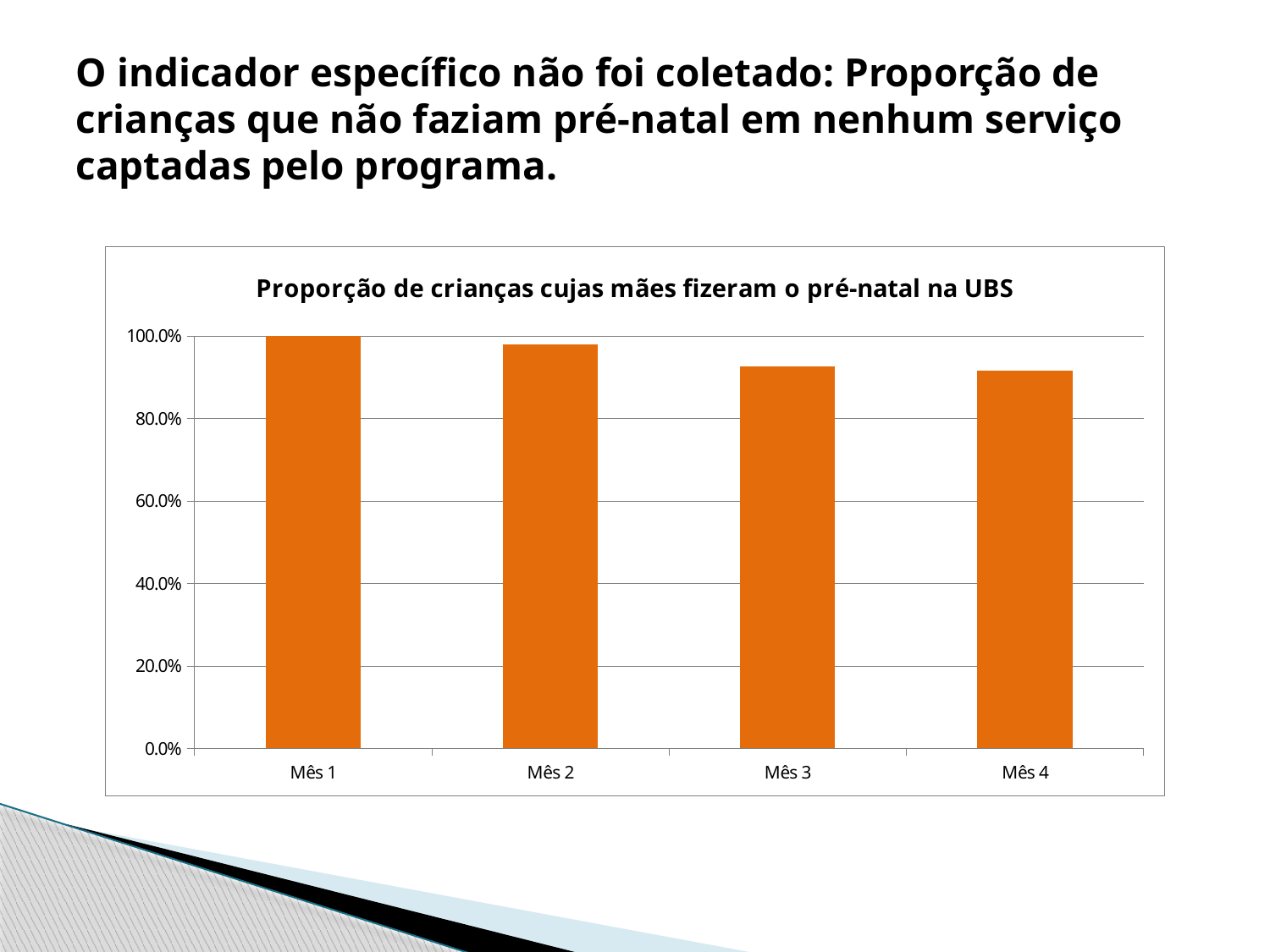
Which is larger, the value for Mês 2 or the value for Mês 4? Mês 2 Do the values rise or fall from Mês 1 to Mês 4? fall Is the value for Mês 3 greater or less than 80.0%? greater What kind of chart is shown on the slide? bar chart Is the value for Mês 2 greater or less than 80.0%? greater Which is larger, the value for Mês 1 or the value for Mês 3? Mês 1 How many categories (months) are plotted on the chart? 4 What colour are the bars in the chart? orange What is the value for Mês 1? 100.0% What is the title of the chart? Proporção de crianças cujas mães fizeram o pré-natal na UBS Which month has the highest proportion of children whose mothers did prenatal care at the UBS? Mês 1 Is the value for Mês 4 greater or less than 100.0%? less